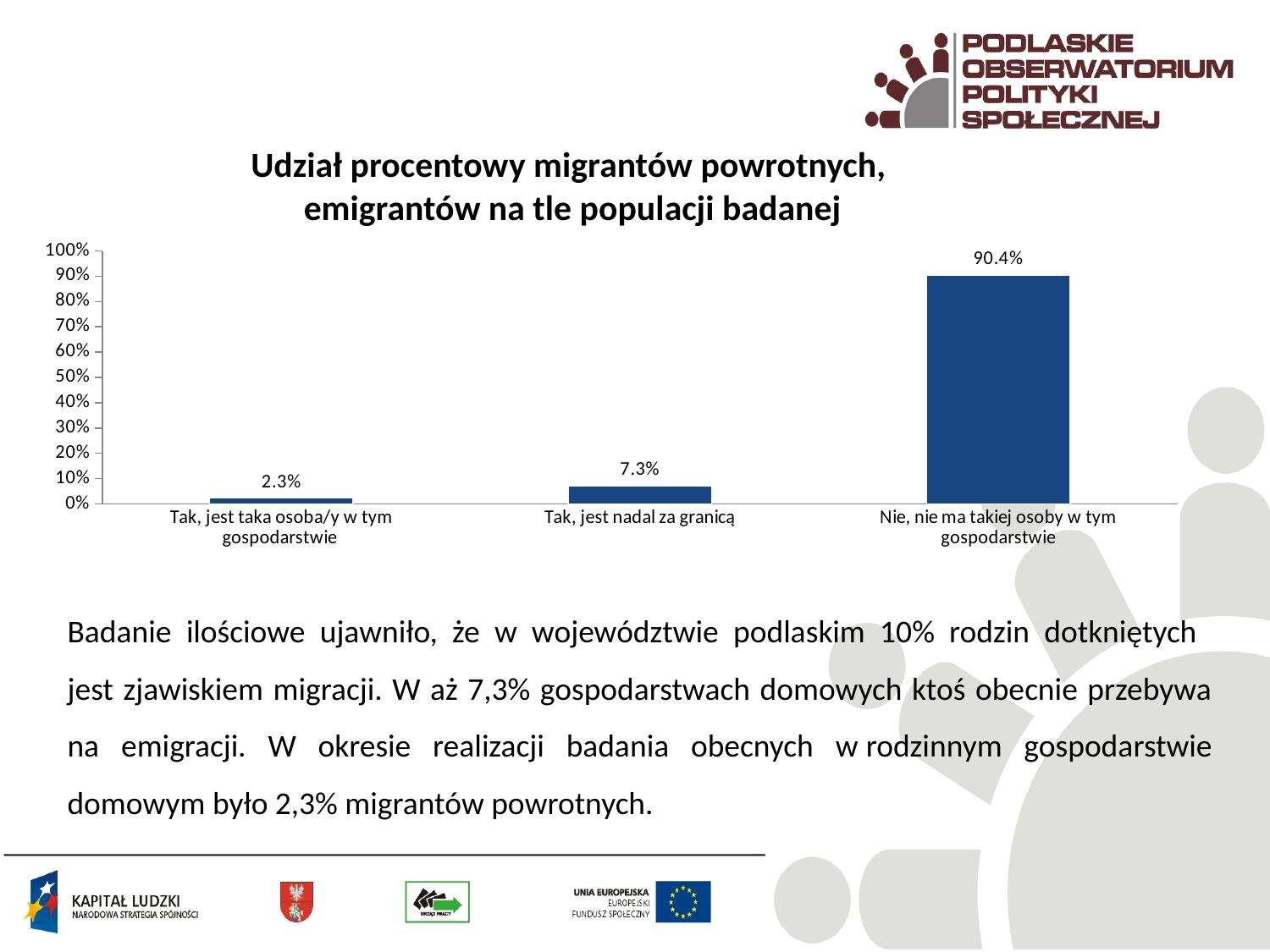
What kind of chart is shown on the slide? bar chart What is the value for "Tak, jest nadal za granicą"? 7.3% What is the value for "Tak, jest taka osoba/y w tym gospodarstwie"? 2.3% What is the title of the chart? Udział procentowy migrantów powrotnych, emigrantów na tle populacji badanej What is the difference between the values for "Tak, jest nadal za granicą" and "Tak, jest taka osoba/y w tym gospodarstwie"? 5.0% Which category has the lowest value? Tak, jest taka osoba/y w tym gospodarstwie What is the difference between the values for "Nie, nie ma takiej osoby w tym gospodarstwie" and "Tak, jest nadal za granicą"? 83.1% Which is larger: the value for "Tak, jest nadal za granicą" or for "Tak, jest taka osoba/y w tym gospodarstwie"? Tak, jest nadal za granicą Which category has the highest value? Nie, nie ma takiej osoby w tym gospodarstwie How many categories are shown on the x axis? 3 Is the value for "Nie, nie ma takiej osoby w tym gospodarstwie" greater or less than 80%? greater What is the value for "Nie, nie ma takiej osoby w tym gospodarstwie"? 90.4%